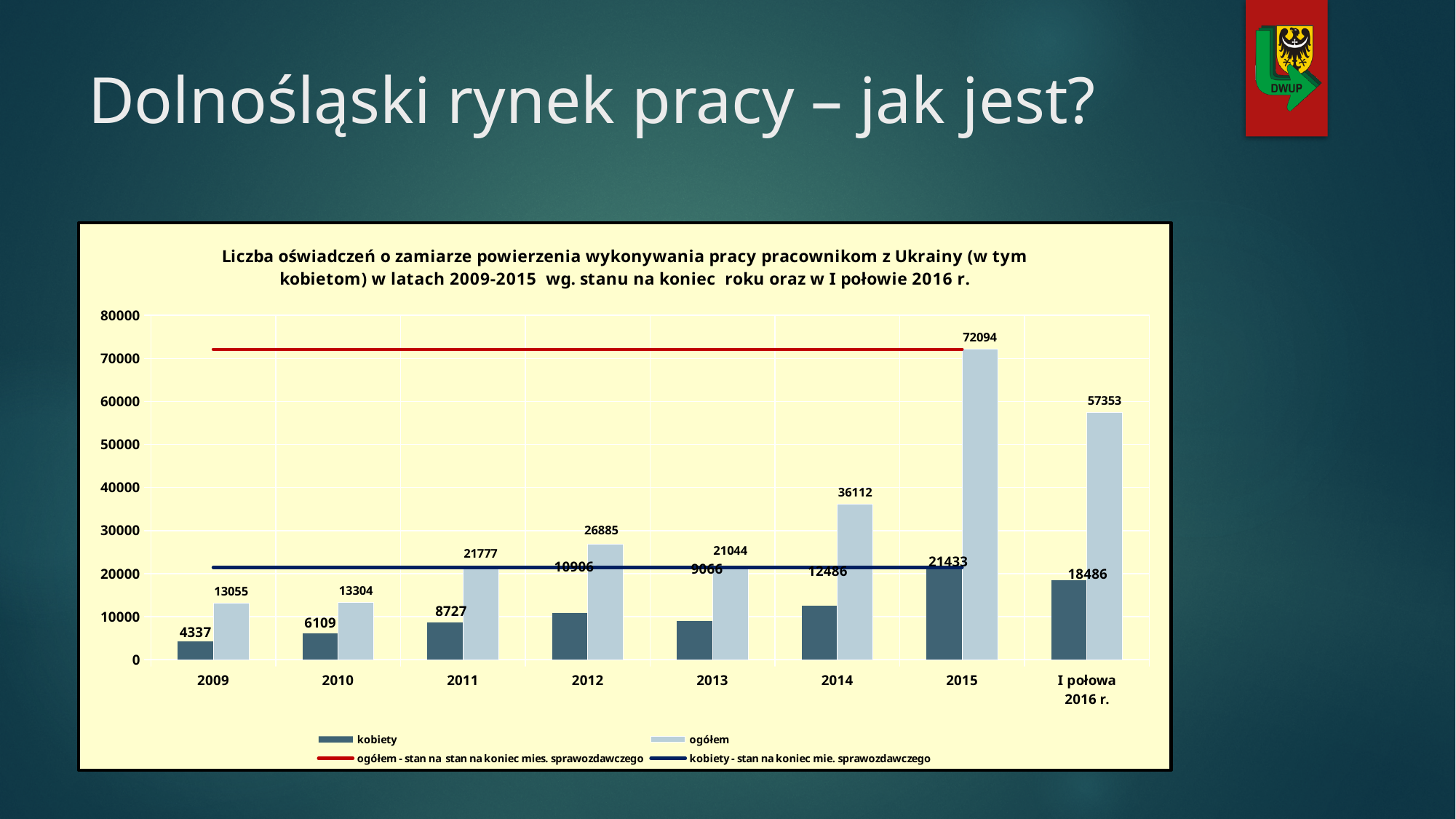
Is the ogółem value for I połowa 2016 r. greater or less than 50000? greater What is the difference between the ogółem values for 2015 and 2014? 35982 In which period is the ogółem bar highest? 2015 What is the value of the ogółem bar for 2015? 72094 Which is larger, the ogółem value for 2011 or for 2013? 2011 What is the value of the kobiety bar for 2015? 21433 What is the value of the kobiety bar for 2009? 4337 What is the difference between the ogółem values for 2010 and 2009? 249 How many periods are shown on the x axis? 8 In which period is the kobiety bar lowest? 2009 What is the value of the ogółem bar for I połowa 2016 r.? 57353 How many series does the legend list? 4